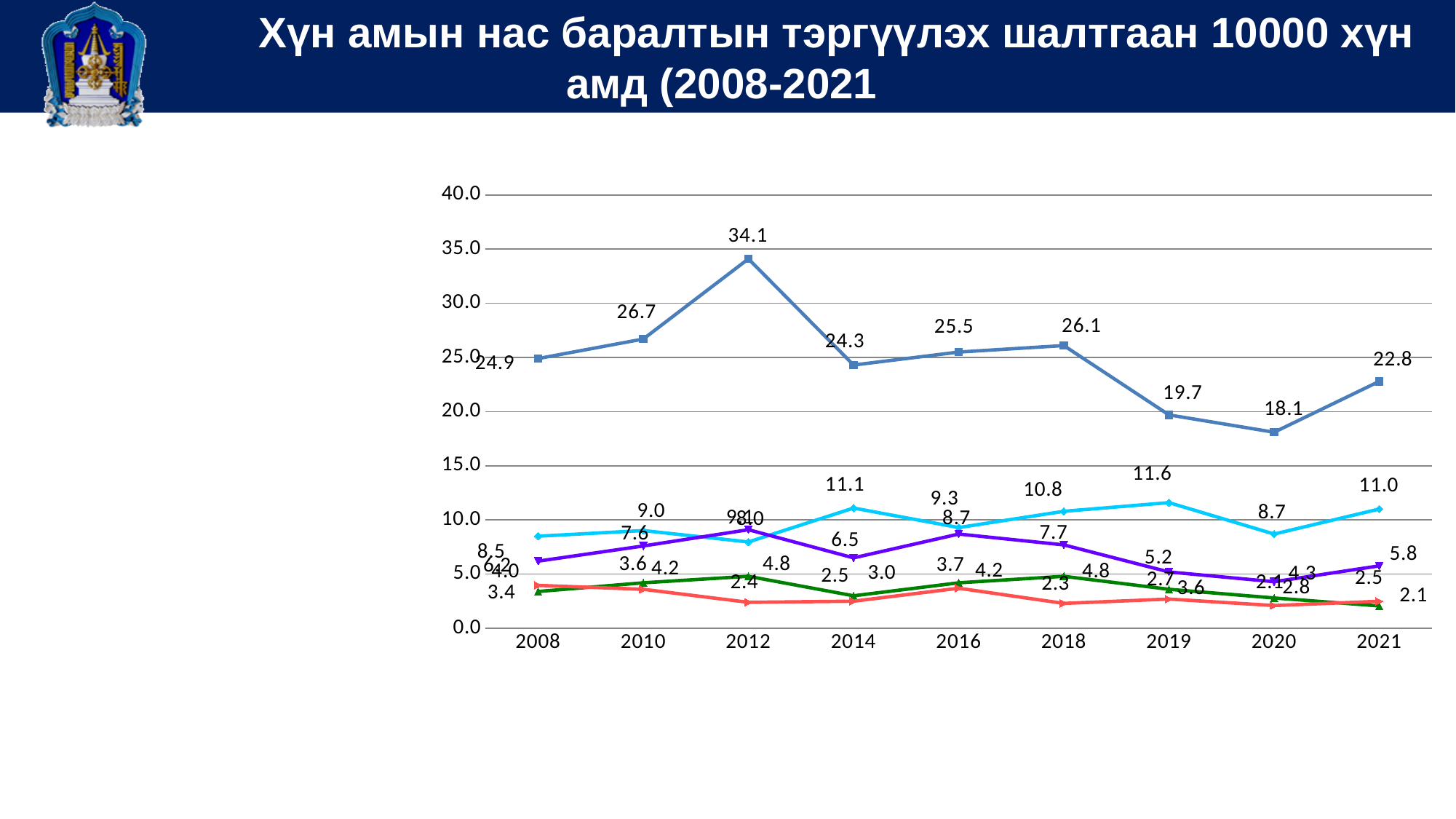
What is the highest value on the top (dark blue) line? 34.1 What kind of chart is shown on the slide? line chart What is the value of the green line in 2021? 2.1 Is the value of the top (dark blue) line in 2020 greater or less than 20.0? less What is the value of the light blue (cyan) line in 2019? 11.6 In which year does the top (dark blue) line reach its highest value? 2012 In which year does the top (dark blue) line reach its lowest value? 2020 What is the difference between the top (dark blue) line's values in 2012 and 2014? 9.8 Which is larger for the top (dark blue) line: the value in 2018 or the value in 2019? 2018 Does the top (dark blue) line rise or fall between 2018 and 2020? fall What is the value of the top (dark blue) line in 2021? 22.8 How many years are shown on the x axis of the chart? 9